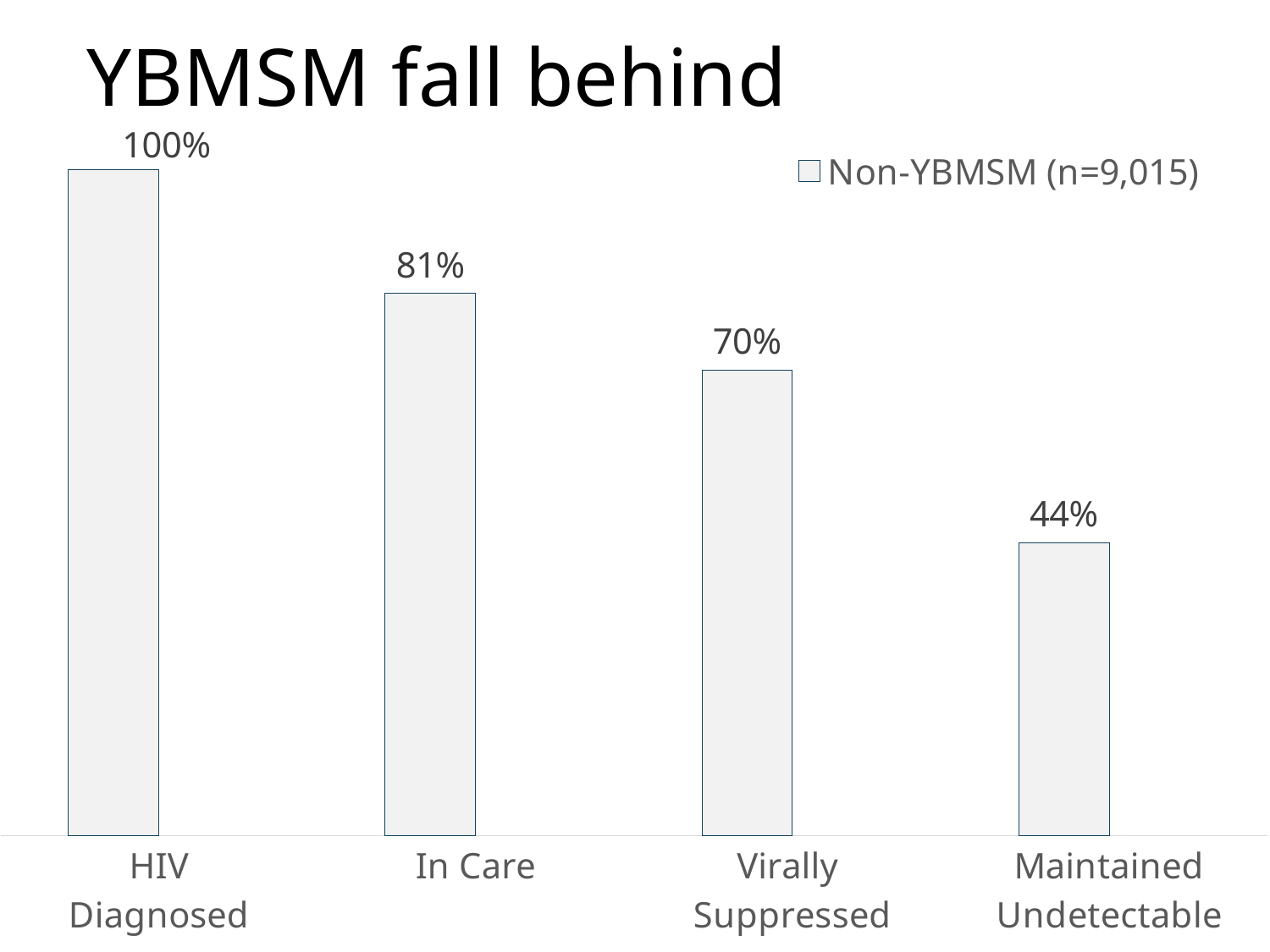
What is the value for HIV Diagnosed? 100% Which category has the lowest value? Maintained Undetectable What kind of chart is shown on the slide? Bar chart What is the difference between the values for In Care and Virally Suppressed? 11% What is the difference between the values for HIV Diagnosed and Maintained Undetectable? 56% What series does the legend list? Non-YBMSM (n=9,015) What is the value for Virally Suppressed? 70% What is the value for Maintained Undetectable? 44% Which category has the highest value? HIV Diagnosed What is the value for In Care? 81% Which is larger, the value for Virally Suppressed or the value for Maintained Undetectable? Virally Suppressed How many categories are shown on the x axis? 4